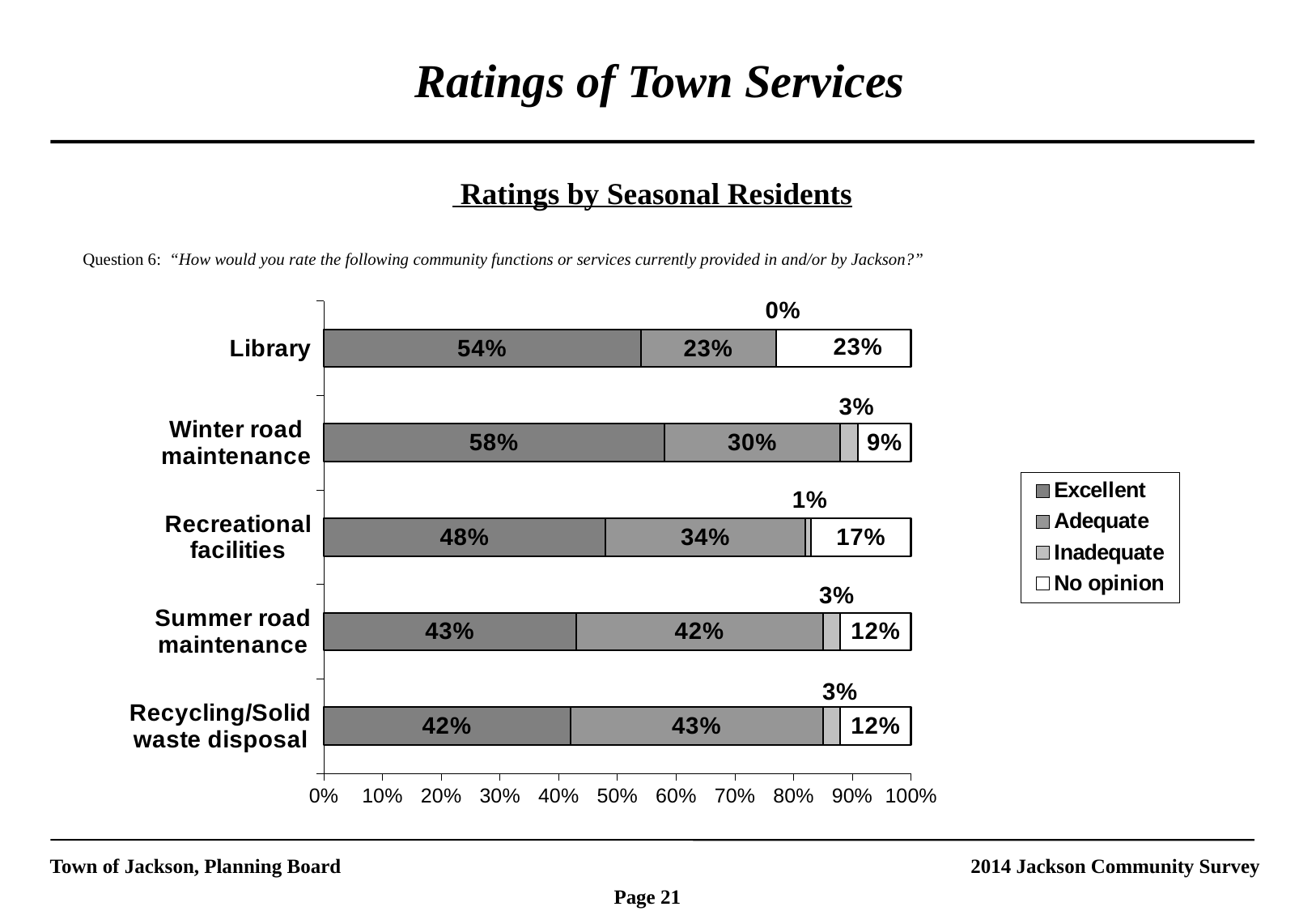
Which is larger: the No opinion percentage for the Library or for Recreational facilities? Library What is the difference between the Excellent percentages for Winter road maintenance and Recycling/Solid waste disposal? 16% What type of chart is shown on the slide? Stacked bar chart How many rating categories does the legend list? 4 Which service has the highest Excellent rating? Winter road maintenance How many services are rated in the chart? 5 What percentage rated Recreational facilities as Inadequate? 1% What is the Adequate percentage for Summer road maintenance? 42% Which service has the lowest Inadequate rating? Library What is the No opinion percentage for Winter road maintenance? 9% What percentage of seasonal residents rated the Library as Excellent? 54% What is the combined Excellent and Adequate percentage for Recreational facilities? 82%